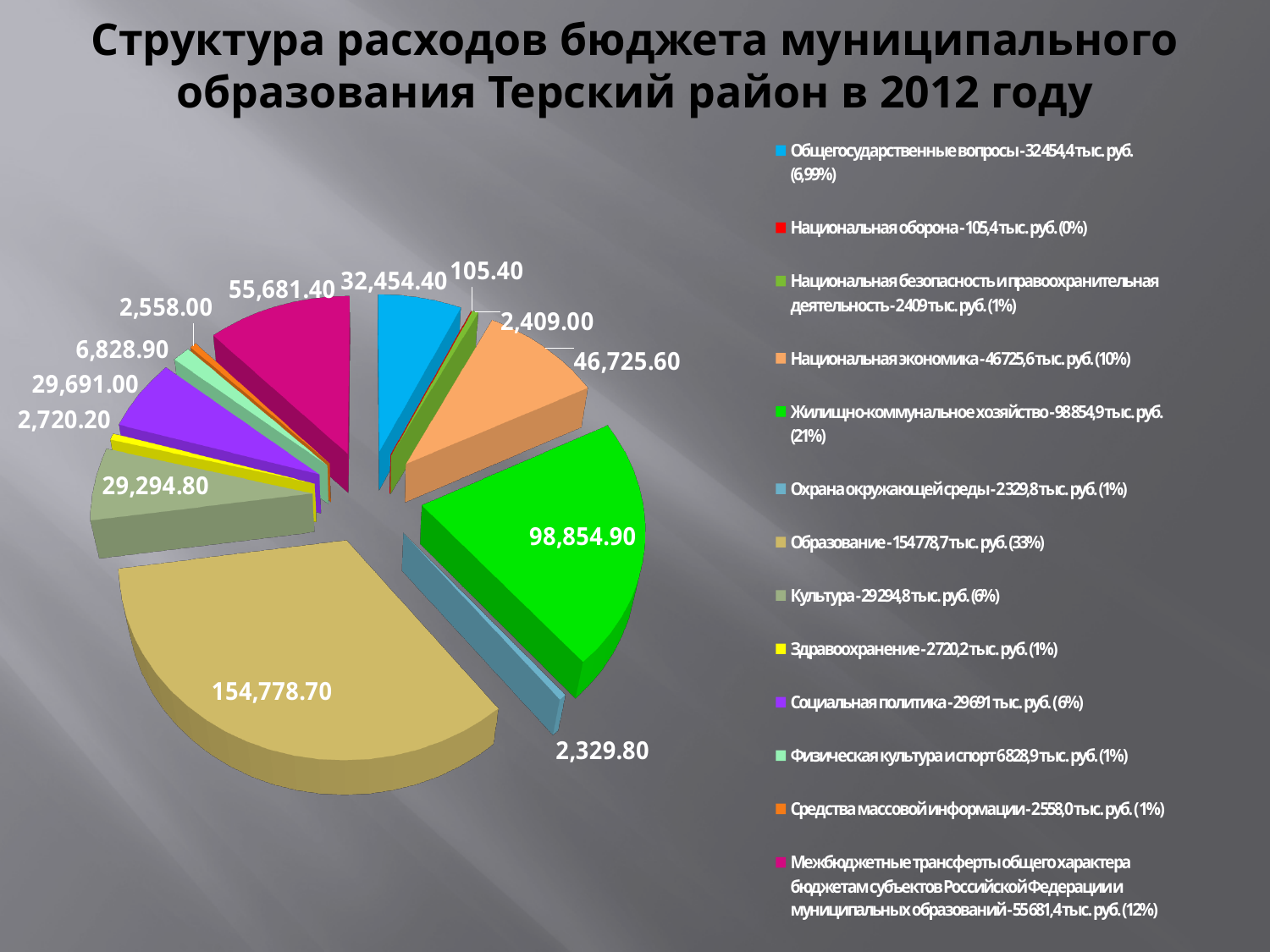
What share of the pie does Жилищно-коммунальное хозяйство account for, according to the legend? 21% What is the value shown for Жилищно-коммунальное хозяйство? 98,854.90 Which category has the largest slice of the pie? Образование What is the value shown for Национальная экономика? 46,725.60 How many categories does the legend list? 13 Which category has the smallest slice of the pie? Национальная оборона What is the value shown for Национальная оборона? 105.40 What type of chart is shown on the slide? pie chart What is the value shown for Образование? 154,778.70 Which is larger: the value for Социальная политика or the value for Культура? Социальная политика What share of the pie does Образование account for, according to the legend? 33% What is the difference between the values for Образование and Жилищно-коммунальное хозяйство? 55,923.80